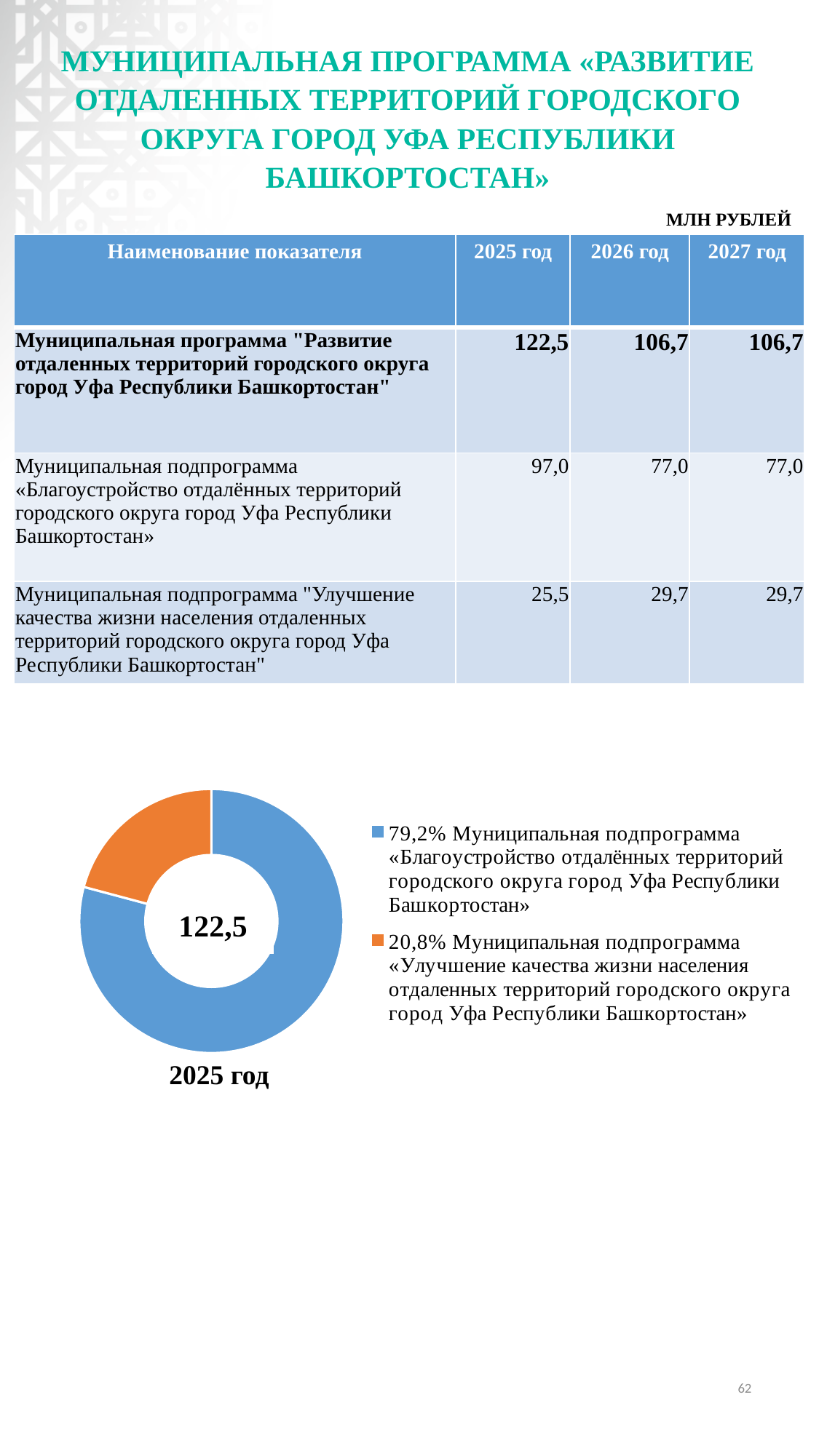
What total value is printed in the centre of the donut chart? 122,5 Which subprogram has the largest slice in the donut chart? Муниципальная подпрограмма «Благоустройство отдалённых территорий городского округа город Уфа Республики Башкортостан» Which year is the donut chart labelled with? 2025 год Which subprogram has the smallest slice in the donut chart? Муниципальная подпрограмма «Улучшение качества жизни населения отдаленных территорий городского округа город Уфа Республики Башкортостан» What kind of chart is shown at the bottom of the slide? Pie chart (donut) How many slices does the donut chart for 2025 год have? 2 What share of the donut chart is taken by the subprogram «Благоустройство отдалённых территорий городского округа город Уфа Республики Башкортостан»? 79,2% How many entries does the legend of the donut chart list? 2 What colour is the slice for the subprogram «Улучшение качества жизни населения отдаленных территорий» in the donut chart? Orange Which slice is larger in the donut chart: the blue one or the orange one? The blue one What share of the donut chart is taken by the subprogram «Улучшение качества жизни населения отдаленных территорий городского округа город Уфа Республики Башкортостан»? 20,8% By how many percentage points does the share of «Благоустройство отдалённых территорий» exceed the share of «Улучшение качества жизни населения» in the donut chart? 58,4